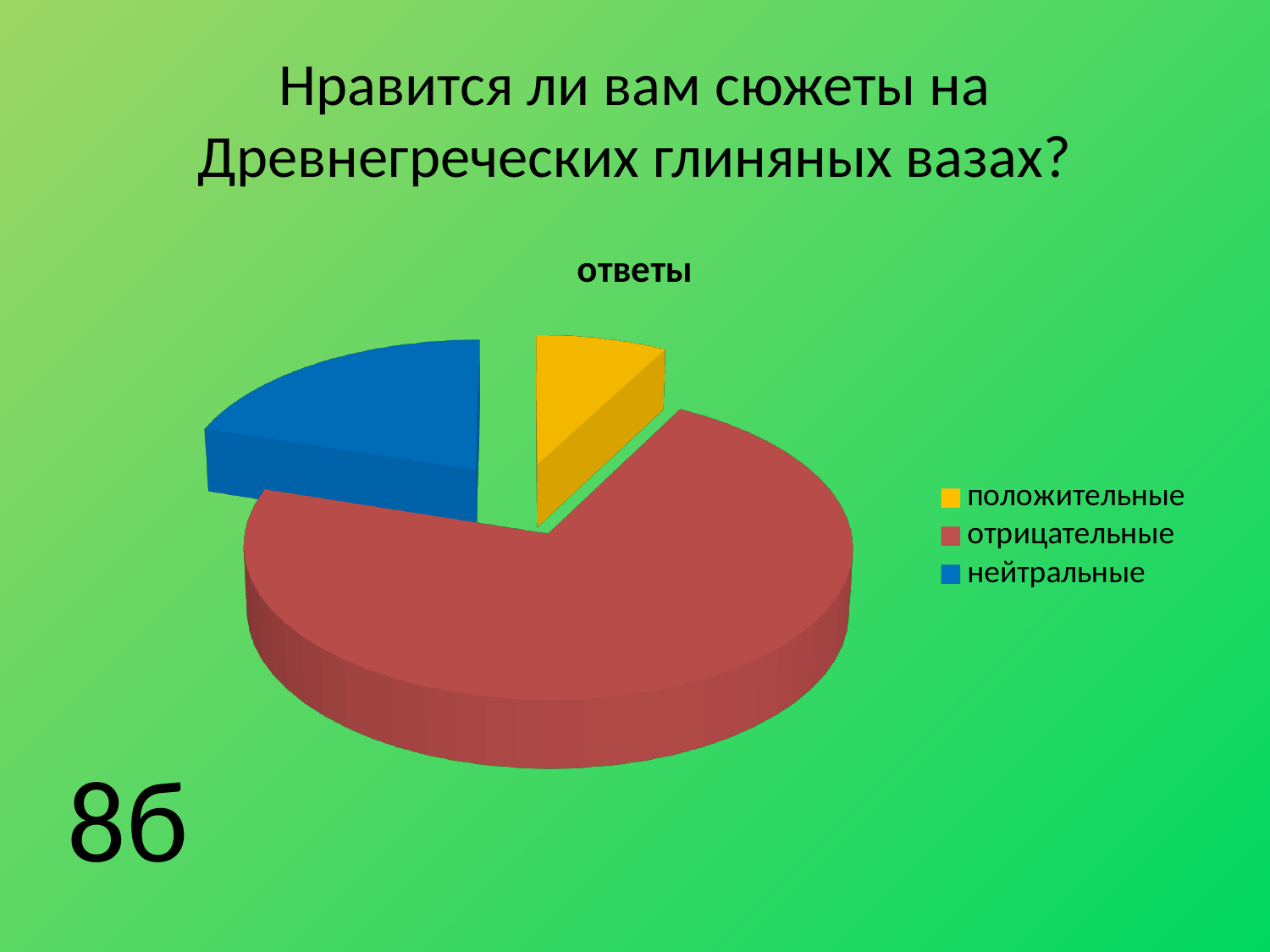
How many entries does the legend list? 3 What kind of chart is shown on the slide? pie chart Which category has the smallest slice of the pie? положительные Which slice is larger, нейтральные or положительные? нейтральные What is the title of the chart? ответы Which category has the largest slice of the pie? отрицательные How many slices does the pie chart have? 3 What colour is the slice for отрицательные? red Which slice is larger, отрицательные or нейтральные? отрицательные